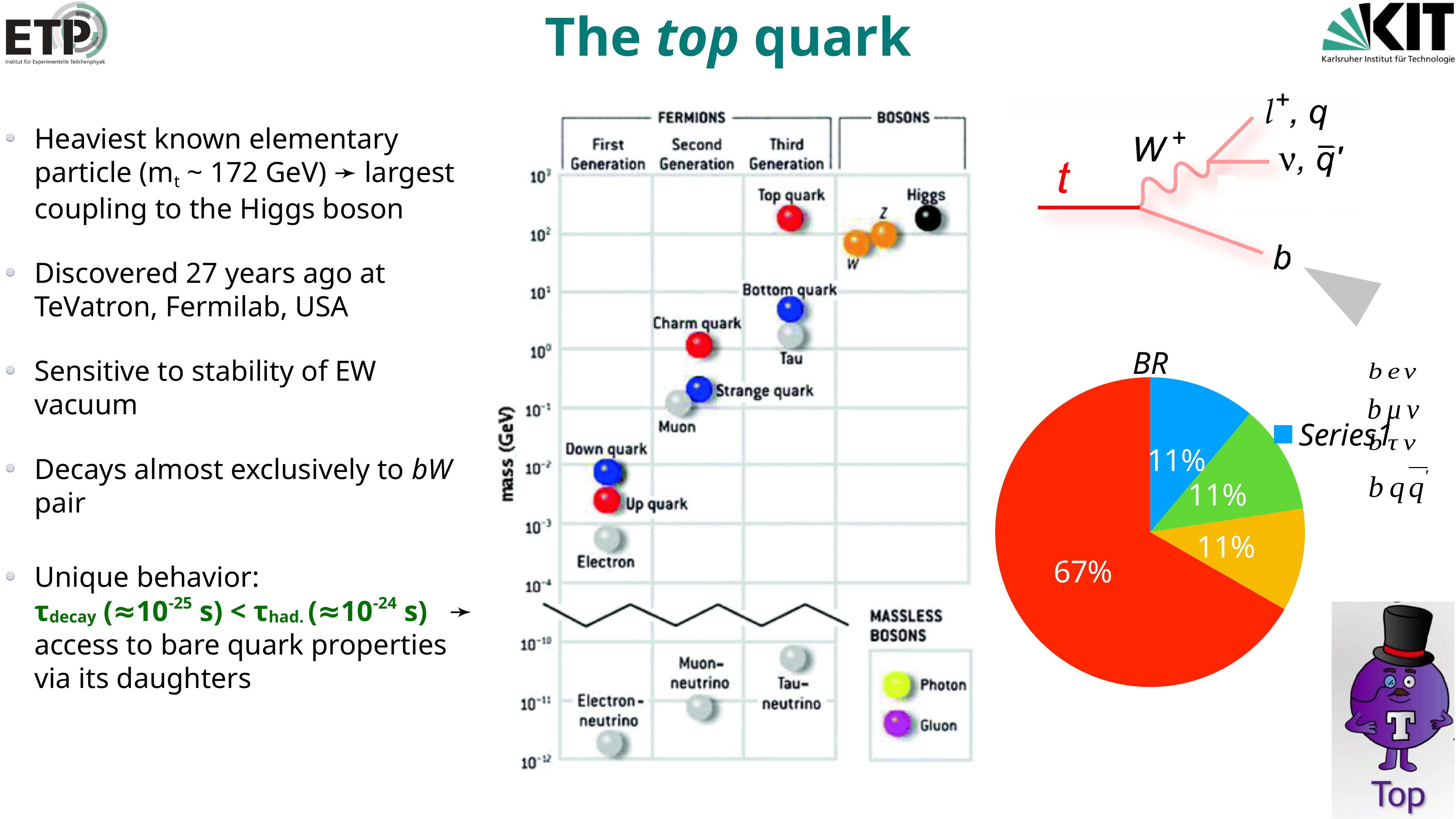
In the pie chart titled "BR", what colour is the 67% slice? red In the pie chart titled "BR", what is the combined share of the three 11% slices? 33% What is the title of the pie chart on the right of the slide? BR In the pie chart titled "BR", what is the difference between the largest slice and one of the 11% slices? 56% In the pie chart titled "BR", how many slices are labelled 11%? 3 In the pie chart titled "BR", is the red slice larger or smaller than the blue slice? larger How many slices does the pie chart titled "BR" have? 4 In the pie chart titled "BR", what is the value of the smallest slice? 11% In the pie chart titled "BR", what is the value of the largest slice? 67% What kind of chart is the chart titled "BR"? pie chart